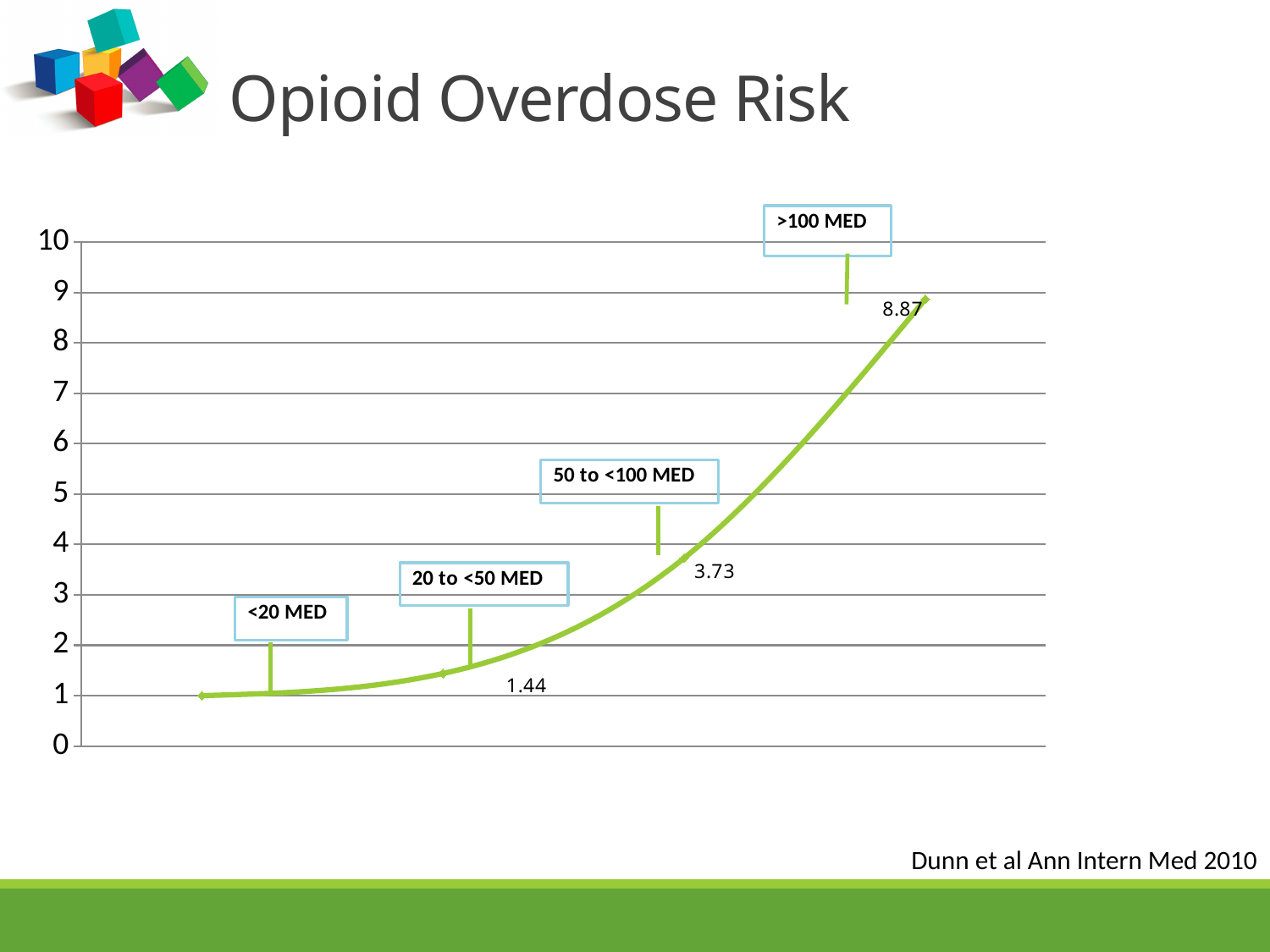
What is the value for 20 to <50 MED? 1.44 What is the difference between the values for 50 to <100 MED and 20 to <50 MED? 2.29 Is the value for <20 MED greater or less than 2? less What is the difference between the values for >100 MED and 50 to <100 MED? 5.14 Which category has the lowest value? <20 MED What is the value for >100 MED? 8.87 What is the value for 50 to <100 MED? 3.73 How many data points are plotted on the chart? 4 What kind of chart is shown on the slide? line chart Do the values rise or fall as the MED category increases along the x axis? rise Which is larger, the value for 50 to <100 MED or the value for 20 to <50 MED? 50 to <100 MED Which category has the highest value? >100 MED